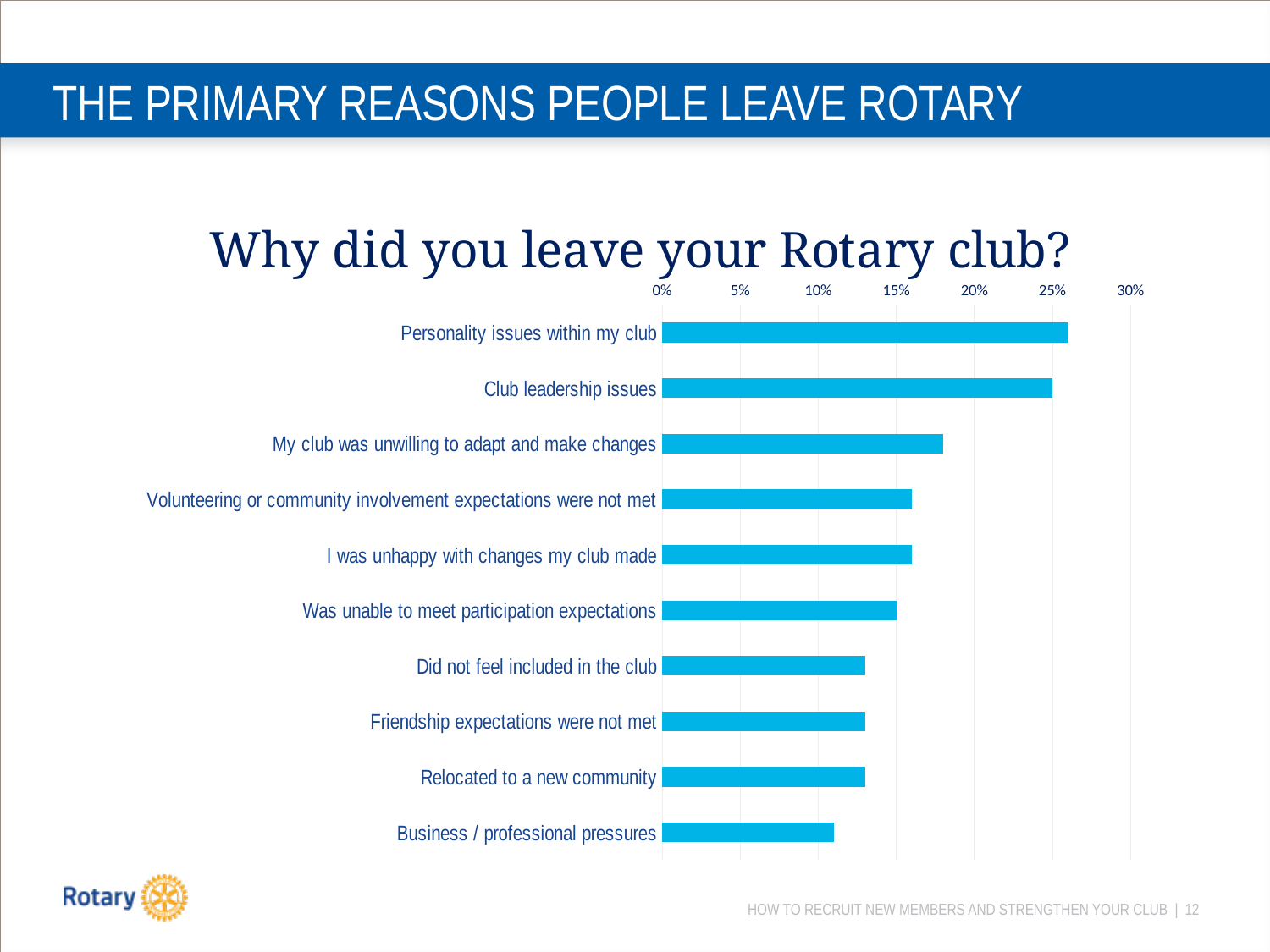
Which reason has the highest value in the chart? Personality issues within my club Is the value for "Personality issues within my club" greater or less than 25%? greater Is the value for "My club was unwilling to adapt and make changes" greater or less than 20%? less Is the value for "Business / professional pressures" greater or less than 10%? greater What is the title of the chart? Why did you leave your Rotary club? Which reason has the lowest value in the chart? Business / professional pressures What kind of chart is shown on the slide? bar chart How many reasons (categories) are plotted in the chart? 10 Which is larger: the value for "Club leadership issues" or the value for "Relocated to a new community"? Club leadership issues Which is larger: the value for "My club was unwilling to adapt and make changes" or the value for "Friendship expectations were not met"? My club was unwilling to adapt and make changes What is the highest percentage tick shown on the chart's axis? 30%